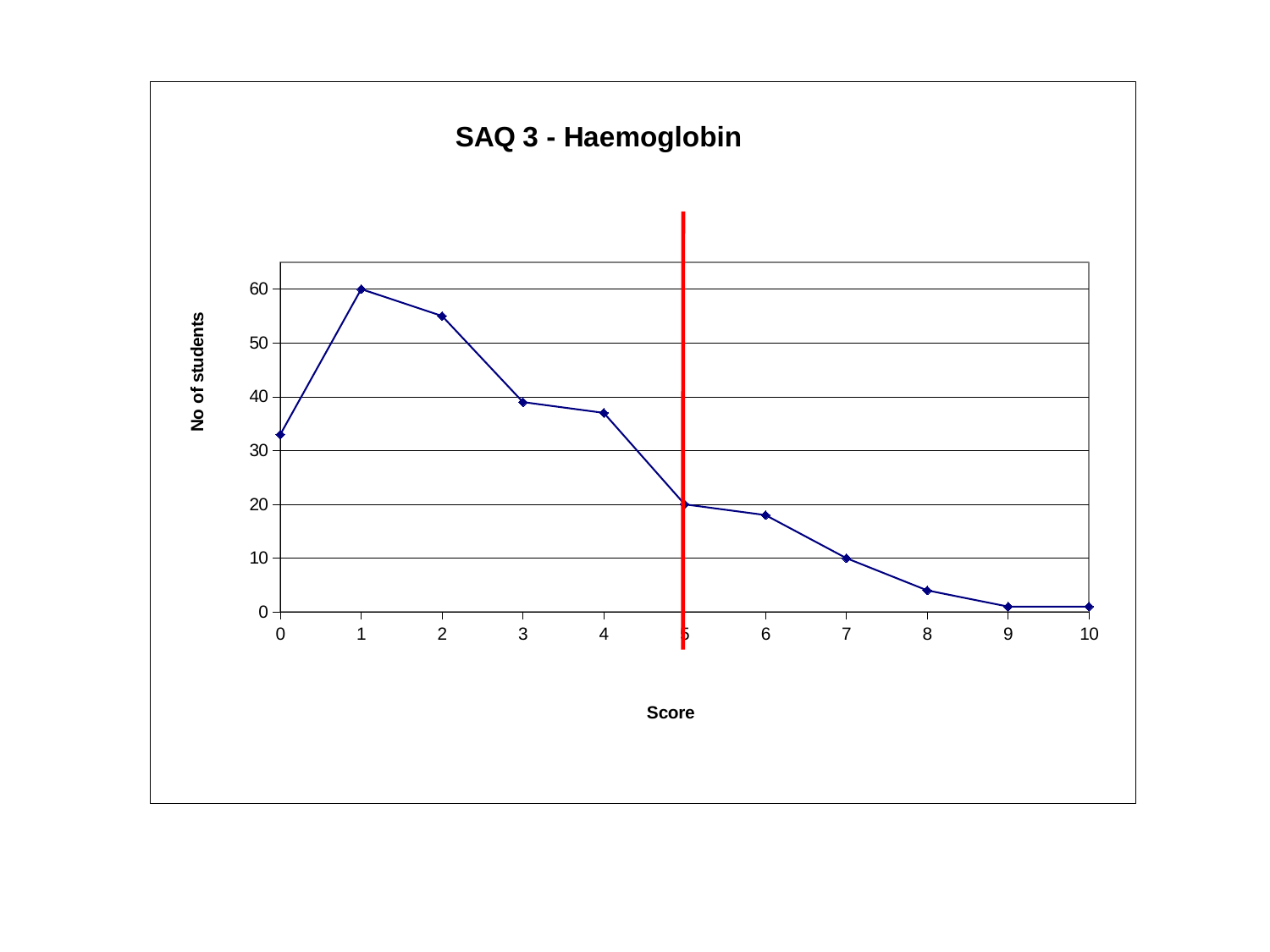
From score 1 to score 10, do the values rise or fall? fall Is the number of students at score 0 greater or less than 30? greater Which score has the highest number of students? 1 What is the number of students at score 5? 20 What is the difference between the number of students at score 1 and at score 7? 50 What is the number of students at score 7? 10 What is the label of the y axis? No of students How many data points are plotted on the line? 11 What is the number of students at score 1? 60 What is the title of the chart? SAQ 3 - Haemoglobin Which has more students, score 2 or score 4? score 2 What type of chart is shown on the slide? line chart